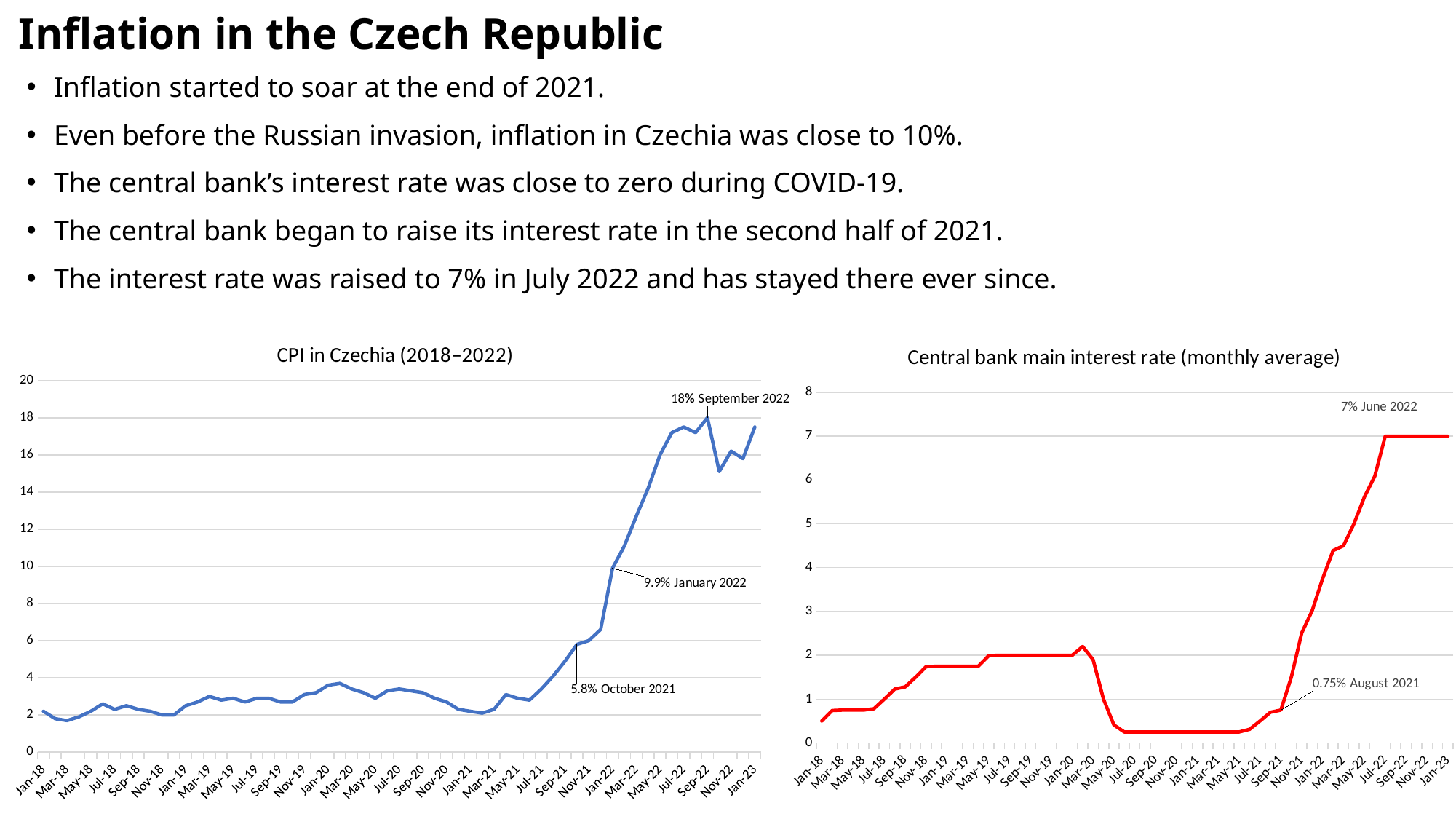
In the 'Central bank main interest rate (monthly average)' chart, what is the difference between the labelled values for June 2022 and August 2021? 6.25% What kind of chart is the 'CPI in Czechia (2018–2022)' chart? Line chart What colour is the line in the 'Central bank main interest rate (monthly average)' chart? Red In the 'CPI in Czechia (2018–2022)' chart, what is the difference between the labelled values for September 2022 and October 2021? 12.2% In the 'CPI in Czechia (2018–2022)' chart, what CPI value is labelled for September 2022? 18% In the 'Central bank main interest rate (monthly average)' chart, what interest rate is labelled for August 2021? 0.75% In the 'CPI in Czechia (2018–2022)' chart, what CPI value is labelled for January 2022? 9.9% In the 'CPI in Czechia (2018–2022)' chart, which labelled point is higher: January 2022 or October 2021? January 2022 In the 'Central bank main interest rate (monthly average)' chart, what interest rate is labelled for June 2022? 7% In the 'CPI in Czechia (2018–2022)' chart, what CPI value is labelled for October 2021? 5.8% In the 'Central bank main interest rate (monthly average)' chart, is the value for Jul-20 greater or less than 1? less In the 'CPI in Czechia (2018–2022)' chart, is the value for Jan-21 greater or less than 4? less